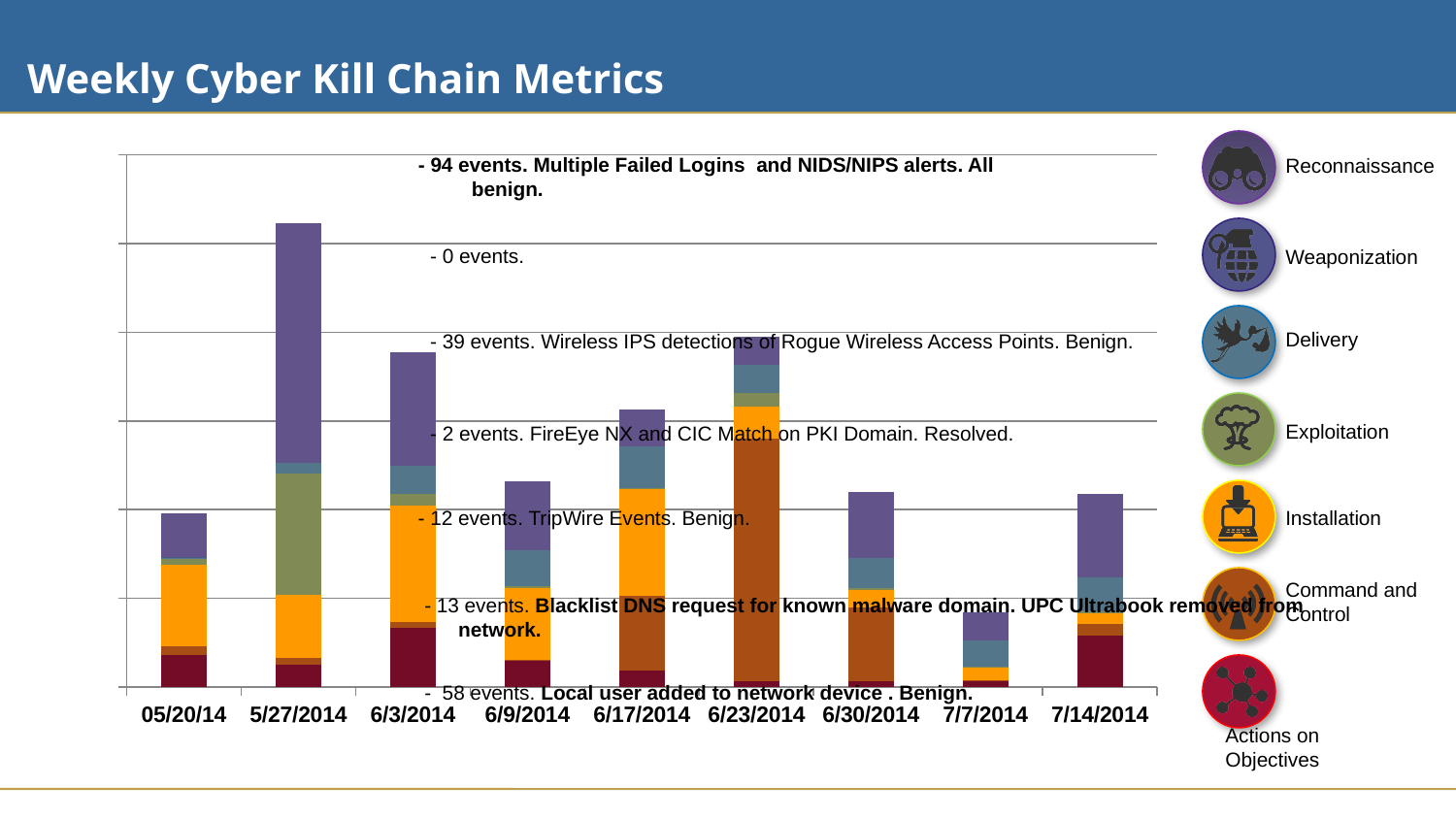
According to the annotation next to the Reconnaissance stage, how many events were recorded? 94 events According to the annotation next to the Delivery stage, how many events were recorded? 39 events Which week has the taller bar, 6/3/2014 or 6/9/2014? 6/3/2014 Which week has the taller bar, 7/7/2014 or 7/14/2014? 7/14/2014 Which week has the taller bar, 6/17/2014 or 6/23/2014? 6/23/2014 Which week has the shortest stacked bar in the chart? 7/7/2014 Which week has the tallest stacked bar in the chart? 5/27/2014 What is the title of the slide containing the chart? Weekly Cyber Kill Chain Metrics How many kill chain stages are listed in the legend on the right of the chart? 7 According to the annotation next to the Weaponization stage, how many events were recorded? 0 events What kind of chart is shown on the slide? Stacked bar chart How many weekly dates are shown along the x axis of the chart? 9